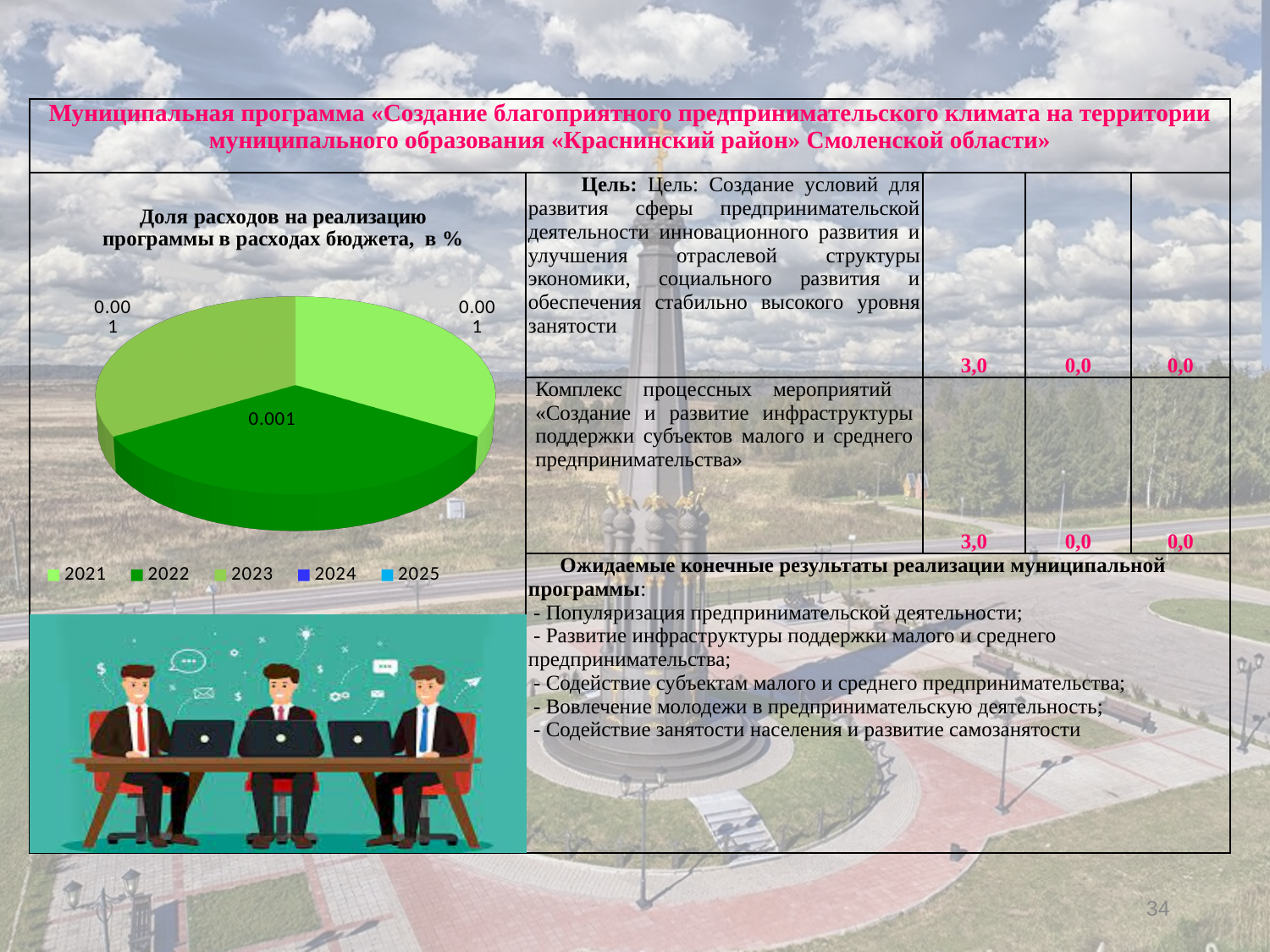
What value is labelled on the dark green slice (2022) of the pie chart? 0.001 How many entries does the legend of the pie chart list? 5 What value is labelled on the 2021 slice of the pie chart? 0.001 Which years are listed in the legend of the pie chart? 2021, 2022, 2023, 2024, 2025 What kind of chart is shown on the slide? pie chart How many slices are visible in the pie chart? 3 What value is labelled on the 2023 slice of the pie chart? 0.001 What is the title of the pie chart? Доля расходов на реализацию программы в расходах бюджета, в %